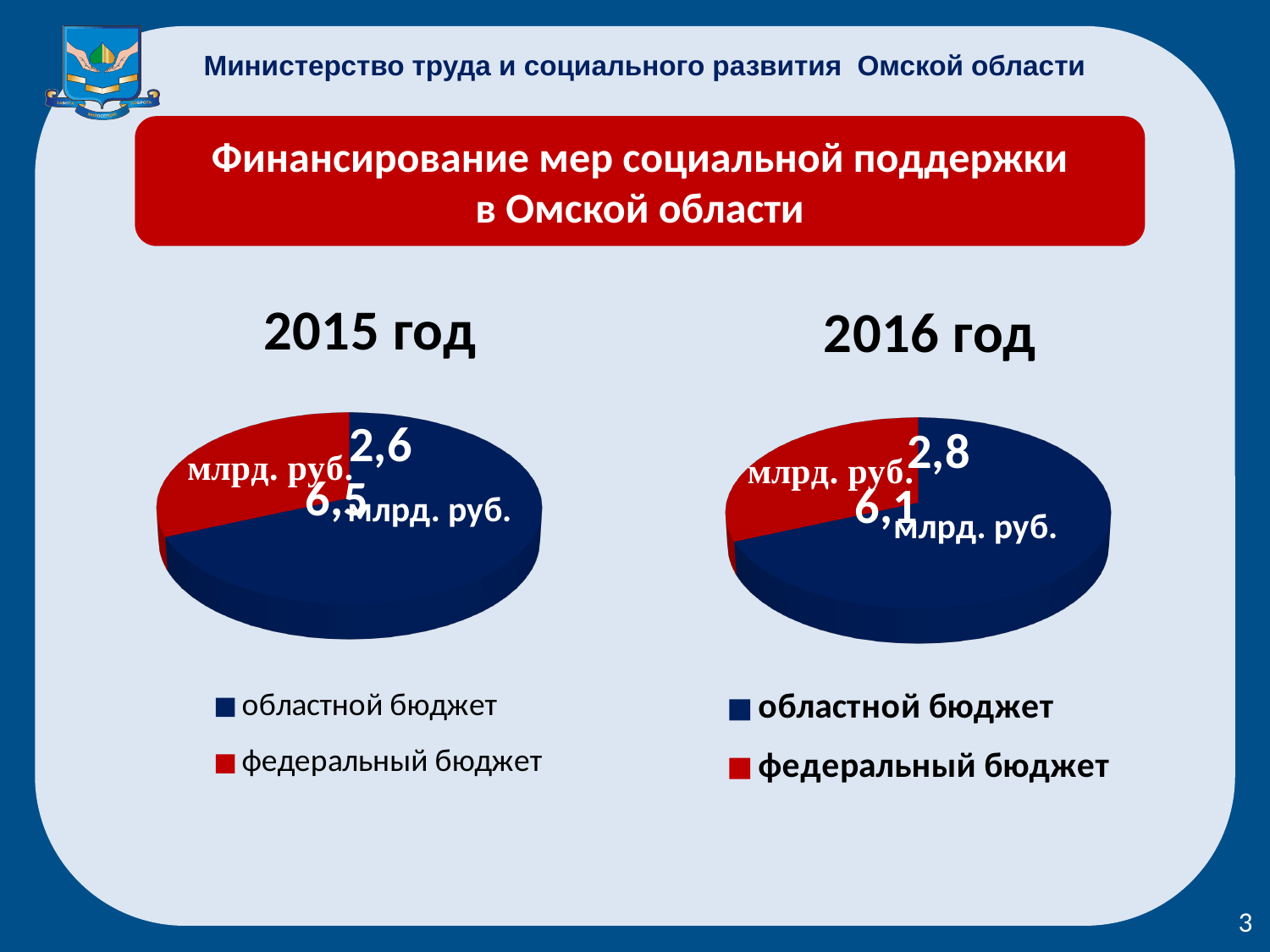
In the 2015 год pie chart, what is the value for федеральный бюджет? 2,6 млрд. руб. What type of chart is used for the 2015 год data? pie chart How many entries does the legend of the 2016 год chart list? 2 In the 2015 год chart, what is the difference between областной бюджет and федеральный бюджет? 3,9 млрд. руб. In the 2015 год pie chart, what is the value for областной бюджет? 6,5 млрд. руб. In the 2016 год pie chart, what is the value for областной бюджет? 6,1 млрд. руб. In the 2016 год chart, what is the difference between областной бюджет and федеральный бюджет? 3,3 млрд. руб. In the 2015 год chart, which slice is the largest? областной бюджет Which is larger: федеральный бюджет in the 2015 год chart or федеральный бюджет in the 2016 год chart? 2016 год In the 2016 год chart, which slice is the smallest? федеральный бюджет In the 2016 год pie chart, what is the value for федеральный бюджет? 2,8 млрд. руб. What colour represents федеральный бюджет in the 2015 год chart? red